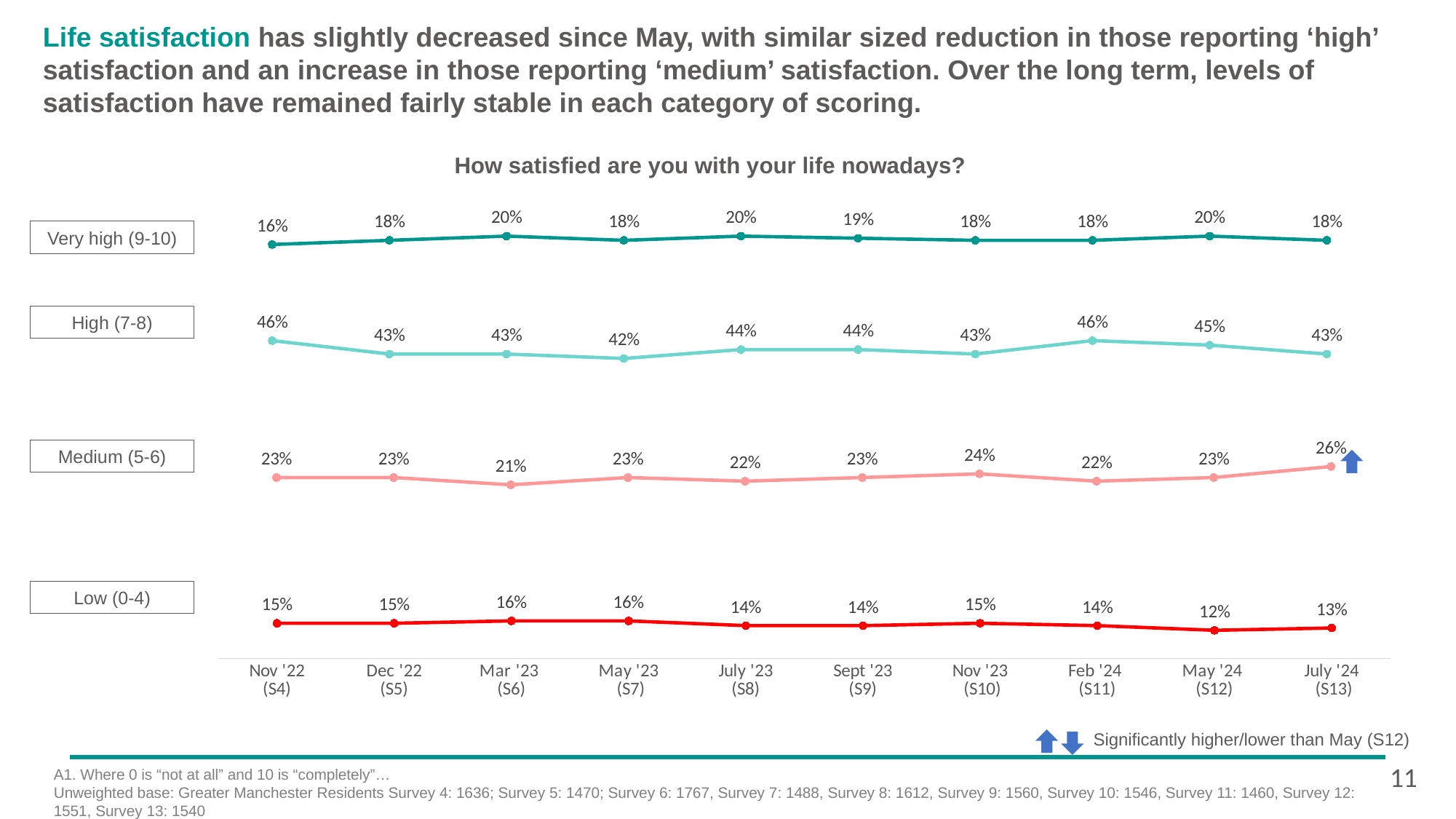
What is the value for Very high (9-10) in Mar '23 (S6)? 20% How many series (satisfaction categories) are plotted on the chart? 4 What is the value for High (7-8) in Nov '22 (S4)? 46% Which is larger in July '24 (S13): the Very high (9-10) value or the Low (0-4) value? Very high (9-10) In which survey wave is the Low (0-4) value lowest? May '24 (S12) What is the value for Medium (5-6) in July '24 (S13)? 26% What is the difference between the High (7-8) value in May '24 (S12) and July '24 (S13)? 2% How many survey waves are plotted along the x axis? 10 What is the value for Low (0-4) in May '24 (S12)? 12% What kind of chart is shown on the slide? Line chart In which survey wave is the Medium (5-6) value highest? July '24 (S13) What is the title of the chart? How satisfied are you with your life nowadays?